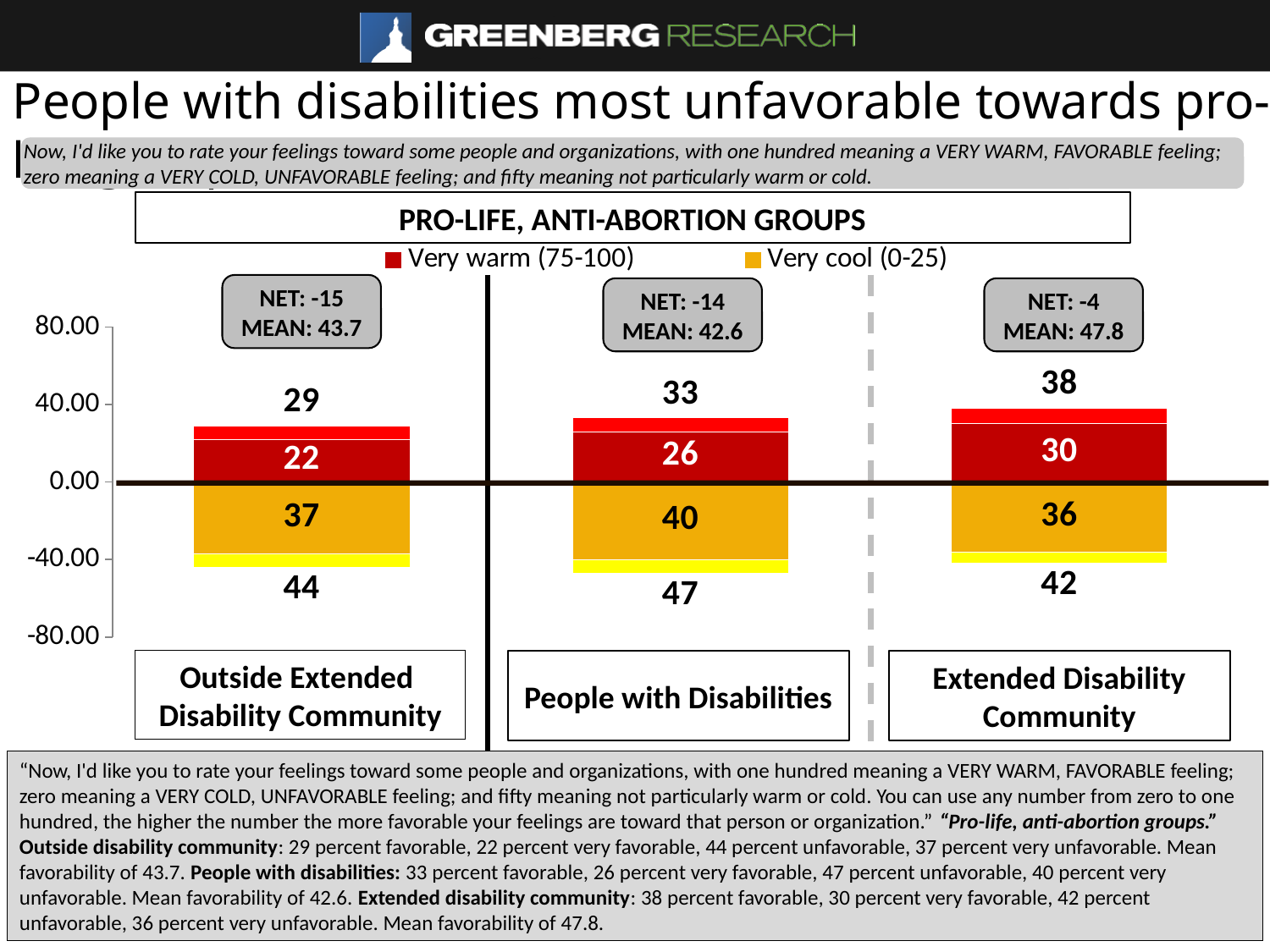
How many series does the chart legend list? 2 What is the title of the chart? PRO-LIFE, ANTI-ABORTION GROUPS How many categories are shown along the x axis of the chart? 3 What is the MEAN value shown for People with Disabilities? 42.6 Which is larger: the Very warm (75-100) value for Outside Extended Disability Community or for People with Disabilities? People with Disabilities What is the Very warm (75-100) value for People with Disabilities? 26 What is the Very cool (0-25) value for Outside Extended Disability Community? 37 What type of chart is shown on the slide? bar chart What is the difference between the Very cool (0-25) value for People with Disabilities and for Extended Disability Community? 4 Which category has the lowest Very cool (0-25) value? Extended Disability Community Which category has the highest Very warm (75-100) value? Extended Disability Community What is the NET value shown for Extended Disability Community? -4